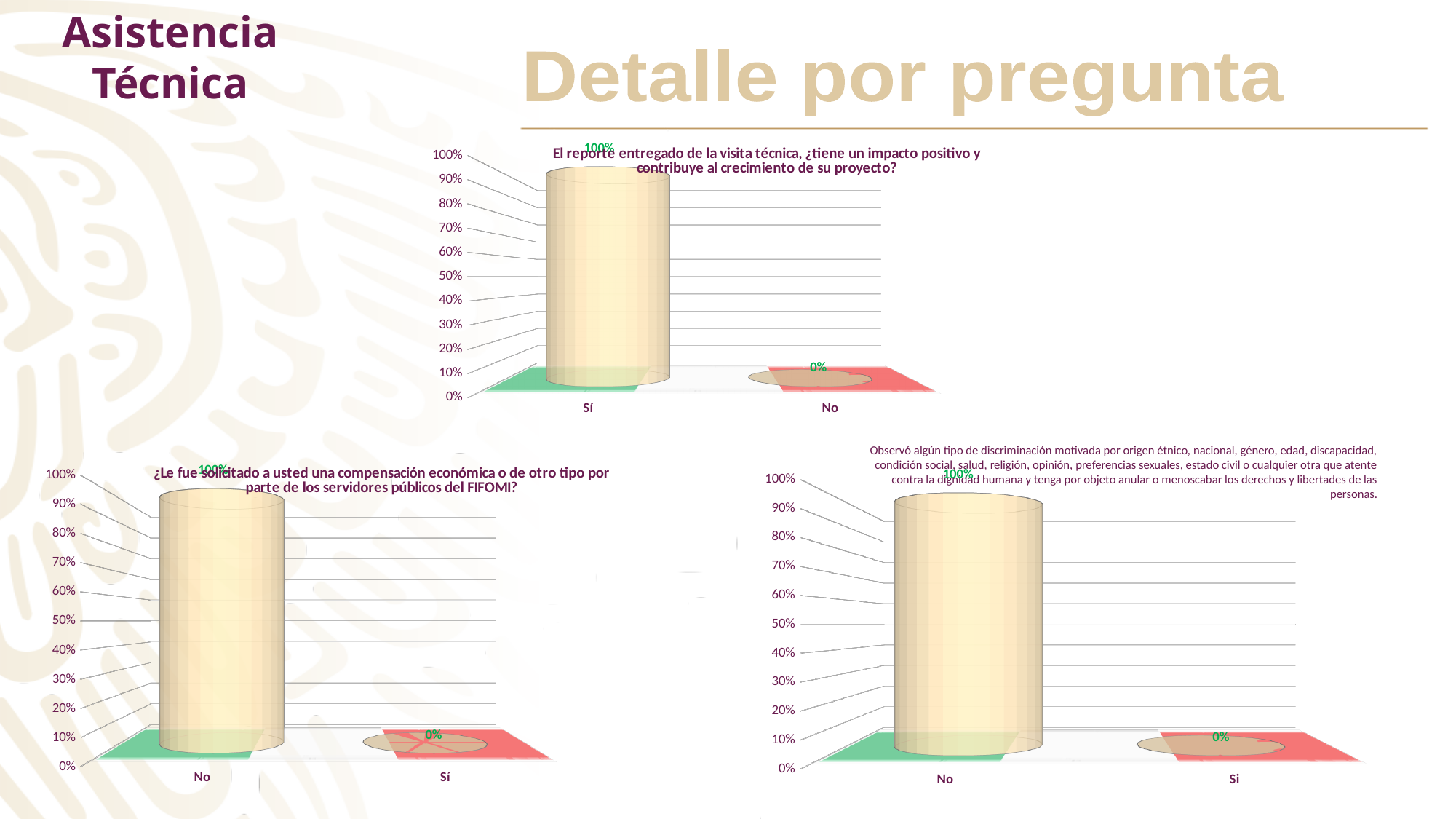
In the top chart, what is the value for No? 0% In the bottom-left chart, what is the value for Sí? 0% In the top chart, which category has the highest value? Sí In the bottom-right chart, what is the difference between the values for No and Si? 100% In the bottom-right chart, what is the value for No? 100% What kind of chart is the top chart? Bar chart In the top chart, what is the value for Sí? 100% In the top chart, which is larger, the value for Sí or the value for No? Sí In the bottom-left chart, what is the value for No? 100% How many categories does the bottom-left chart show? 2 In the bottom-right chart, what is the value for Si? 0% In the bottom-left chart, which category has the lowest value? Sí